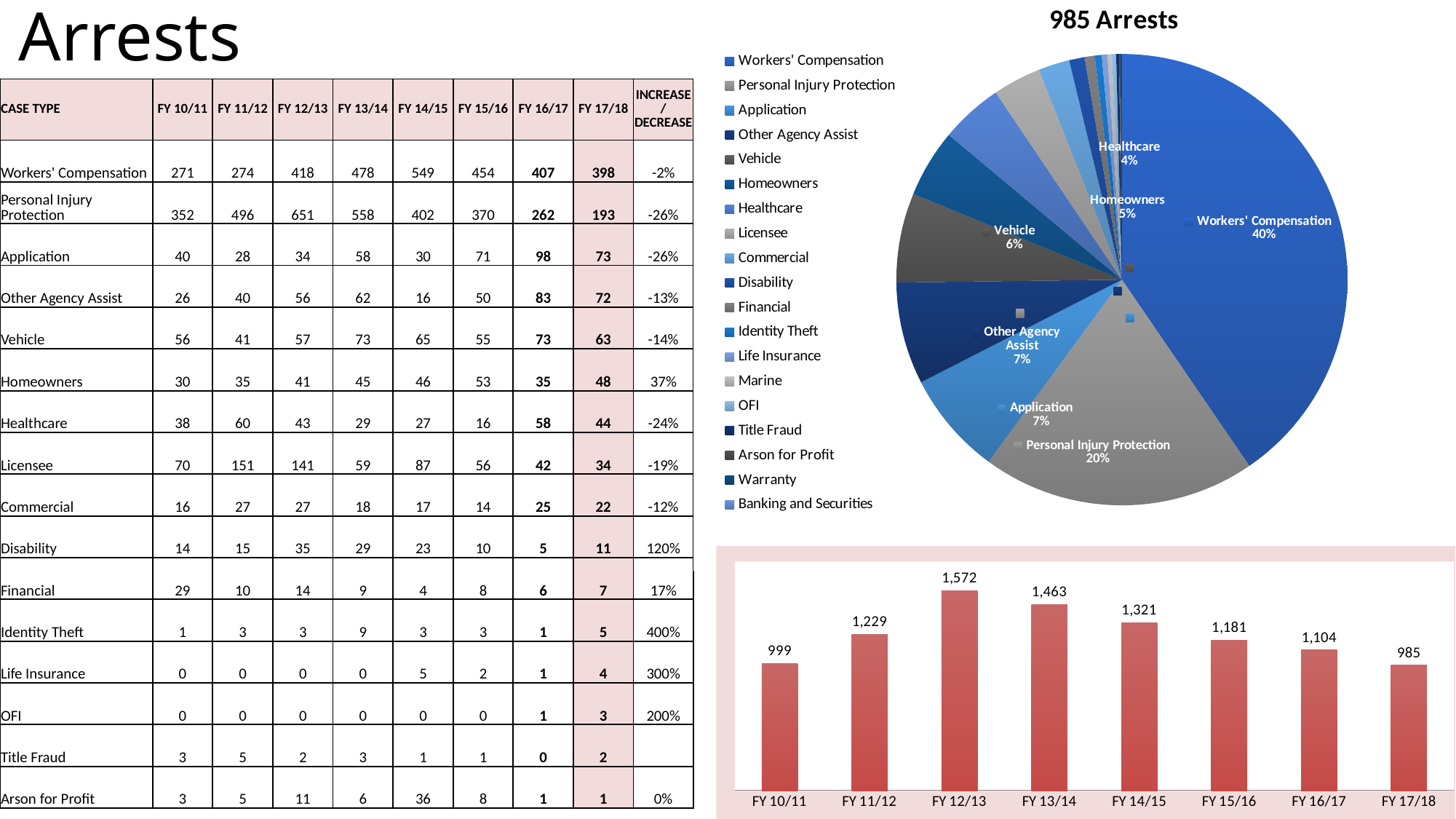
In the pie chart titled "985 Arrests", what share of arrests is Workers' Compensation? 40% In the bar chart at the bottom right, what is the difference between the values for FY 12/13 and FY 17/18? 587 In the bar chart at the bottom right, what is the value for FY 12/13? 1,572 In the bar chart at the bottom right, which fiscal year has the highest value? FY 12/13 How many bars are shown in the bar chart at the bottom right? 8 In the bar chart at the bottom right, do the values rise or fall from FY 12/13 to FY 17/18? fall How many entries does the legend of the pie chart list? 19 In the pie chart titled "985 Arrests", what share of arrests is Personal Injury Protection? 20% In the bar chart at the bottom right, which fiscal year has the lowest value? FY 17/18 What is the title of the pie chart? 985 Arrests In the bar chart at the bottom right, what is the value for FY 17/18? 985 In the pie chart titled "985 Arrests", which case type has the largest slice? Workers' Compensation